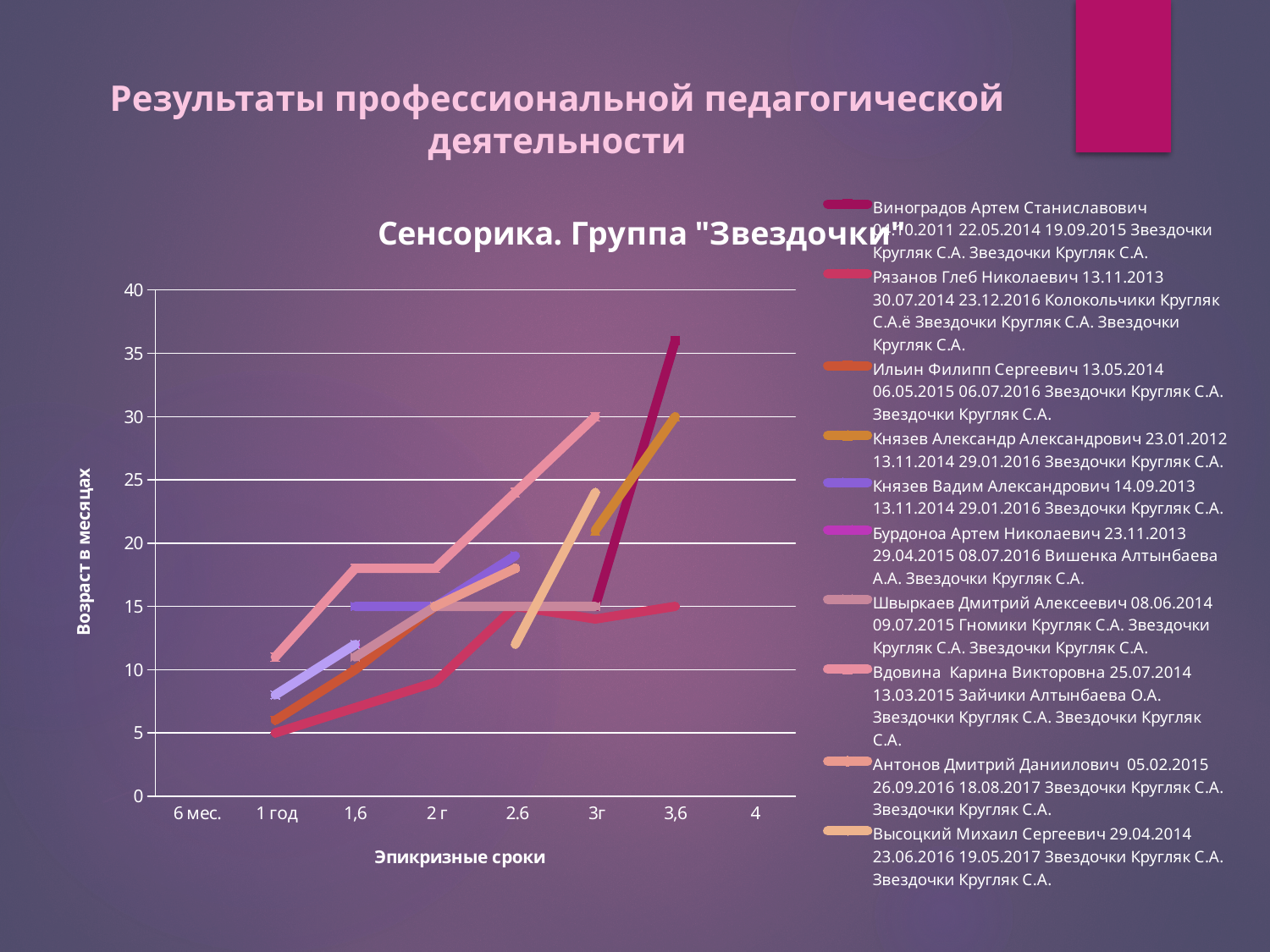
What kind of chart is shown on the slide? line chart What is the label of the vertical axis? Возраст в месяцах What is the title of the chart? Сенсорика. Группа "Звездочки" Is the value for Рязанов Глеб Николаевич at 1,6 greater or less than 10? less Is the value for Рязанов Глеб Николаевич at 3,6 greater or less than 20? less Which series reaches the highest value on the chart? Виноградов Артем Станиславович How many series does the legend list? 10 Does the line for Виноградов Артем Станиславович rise or fall between 3г and 3,6? rise How many categories are shown on the x axis? 8 Does the line for Рязанов Глеб Николаевич generally rise or fall from 1 год to 3,6? rise Is the value for Виноградов Артем Станиславович at 3,6 greater or less than 30? greater